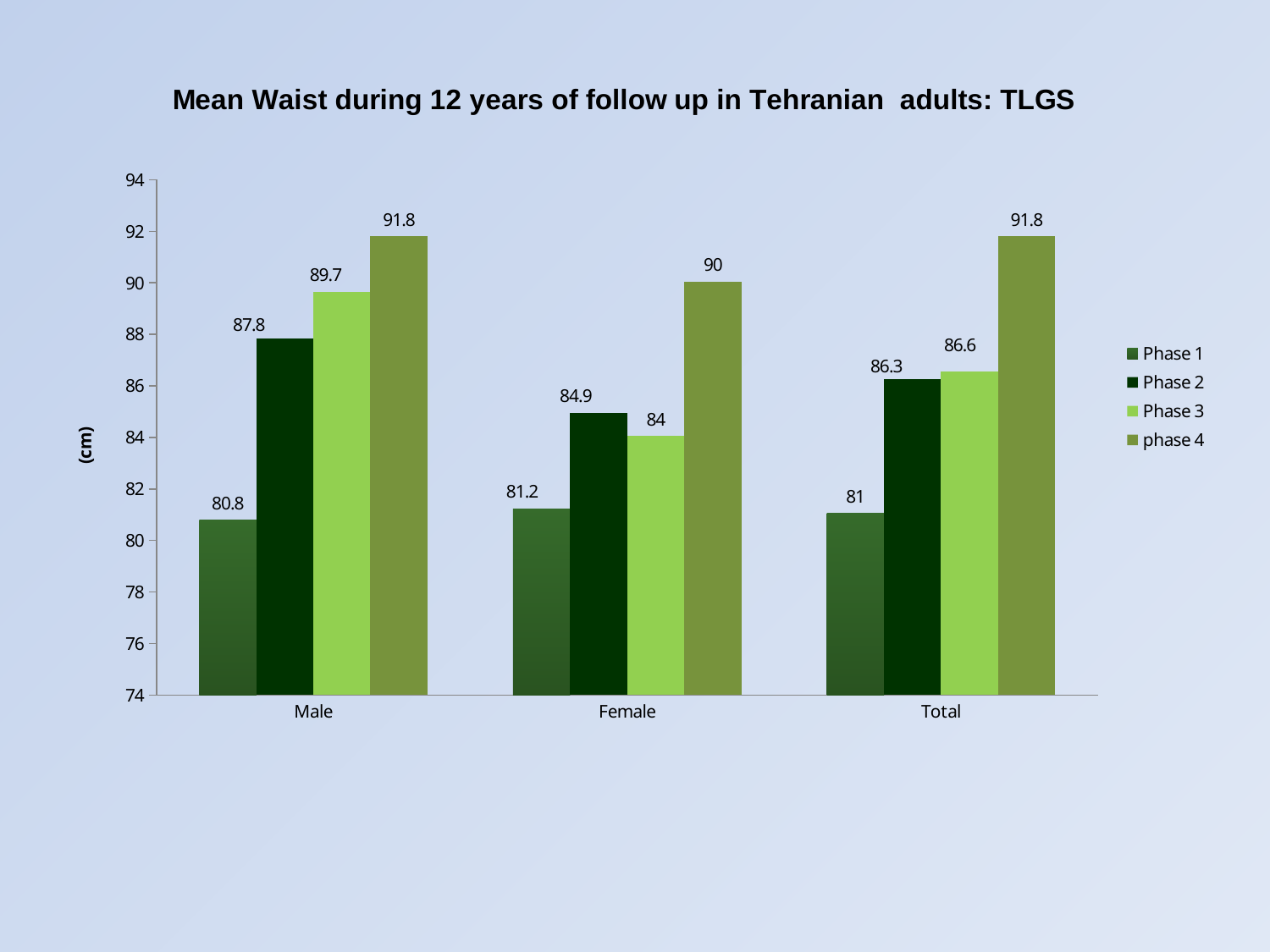
What is the mean waist for Male in Phase 1? 80.8 Which is larger, the Phase 2 value for Male or the Phase 2 value for Female? Male How many categories are shown on the x axis? 3 What is the mean waist for Total in Phase 2? 86.3 What kind of chart is shown on the slide? Bar chart What is the mean waist for Female in Phase 3? 84 Which phase has the highest mean waist for Female? phase 4 What is the difference between the Male phase 4 value and the Male Phase 1 value? 11 Which phase has the lowest mean waist for Male? Phase 1 What is the unit shown on the y axis label? cm How many series does the legend list? 4 What is the mean waist for Female in phase 4? 90